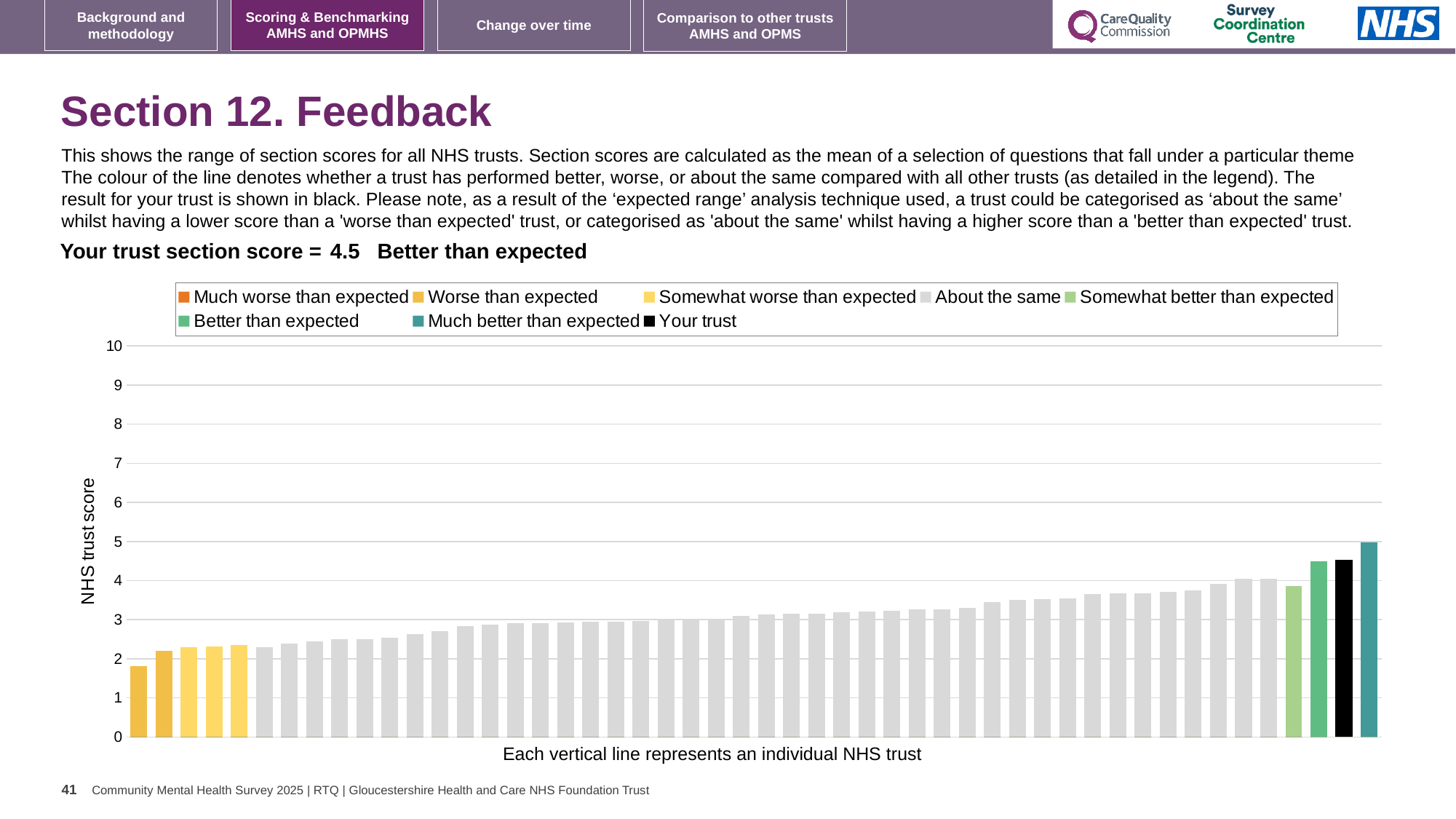
What is the section score for your trust shown on the slide? 4.5 Which benchmarking category is your trust's section score placed in, according to the slide? Better than expected Is the value of the lowest bar in the chart greater or less than 2? less What colour does the legend use for 'Your trust'? Black Do the bar values rise or fall from left to right along the x axis? rise Is the value of the black bar (your trust) greater or less than 4? greater How many entries does the chart legend list? 8 Which legend category does the tallest bar in the chart belong to? Much better than expected What kind of chart is shown on the slide? Bar chart What is the label on the vertical axis of the chart? NHS trust score Is the value of the black bar (your trust) greater or less than 5? less Is the black bar (your trust) taller or shorter than the light green 'Somewhat better than expected' bar? taller